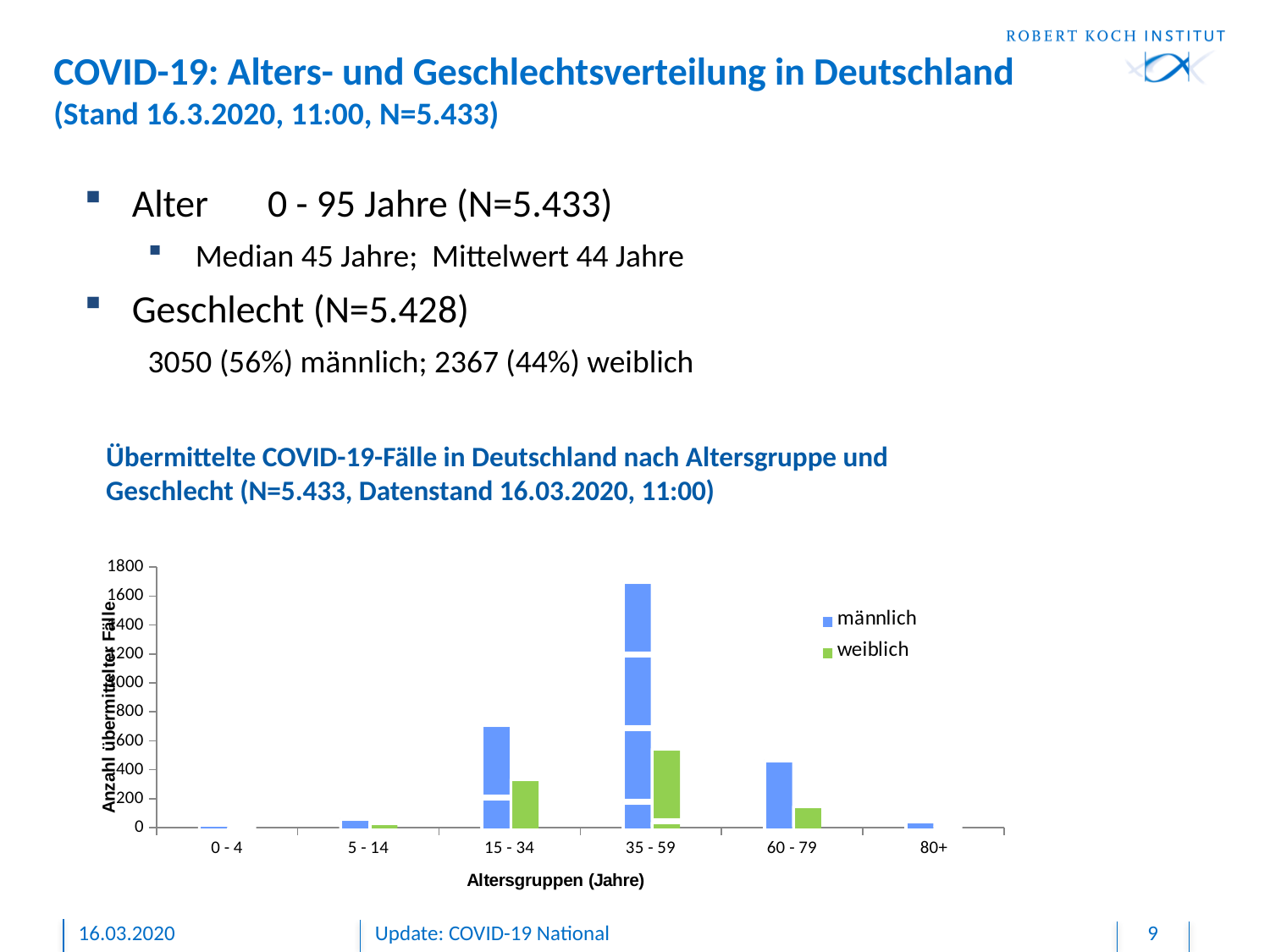
Which age group has the highest value for weiblich? 35 - 59 Is the value for weiblich in the 35 - 59 age group greater or less than 400? greater What kind of chart is shown on the slide? bar chart Which age group has the highest value for männlich? 35 - 59 Is the value for männlich in the 35 - 59 age group greater or less than 1400? greater Is the value for weiblich in the 60 - 79 age group greater or less than 200? less How many series does the chart legend list? 2 In the 15 - 34 age group, which is larger: männlich or weiblich? männlich Which colour represents the weiblich series in the chart? green How many age groups are shown on the x axis of the chart? 6 What is the title of the y axis of the chart? Anzahl übermittelter Fälle